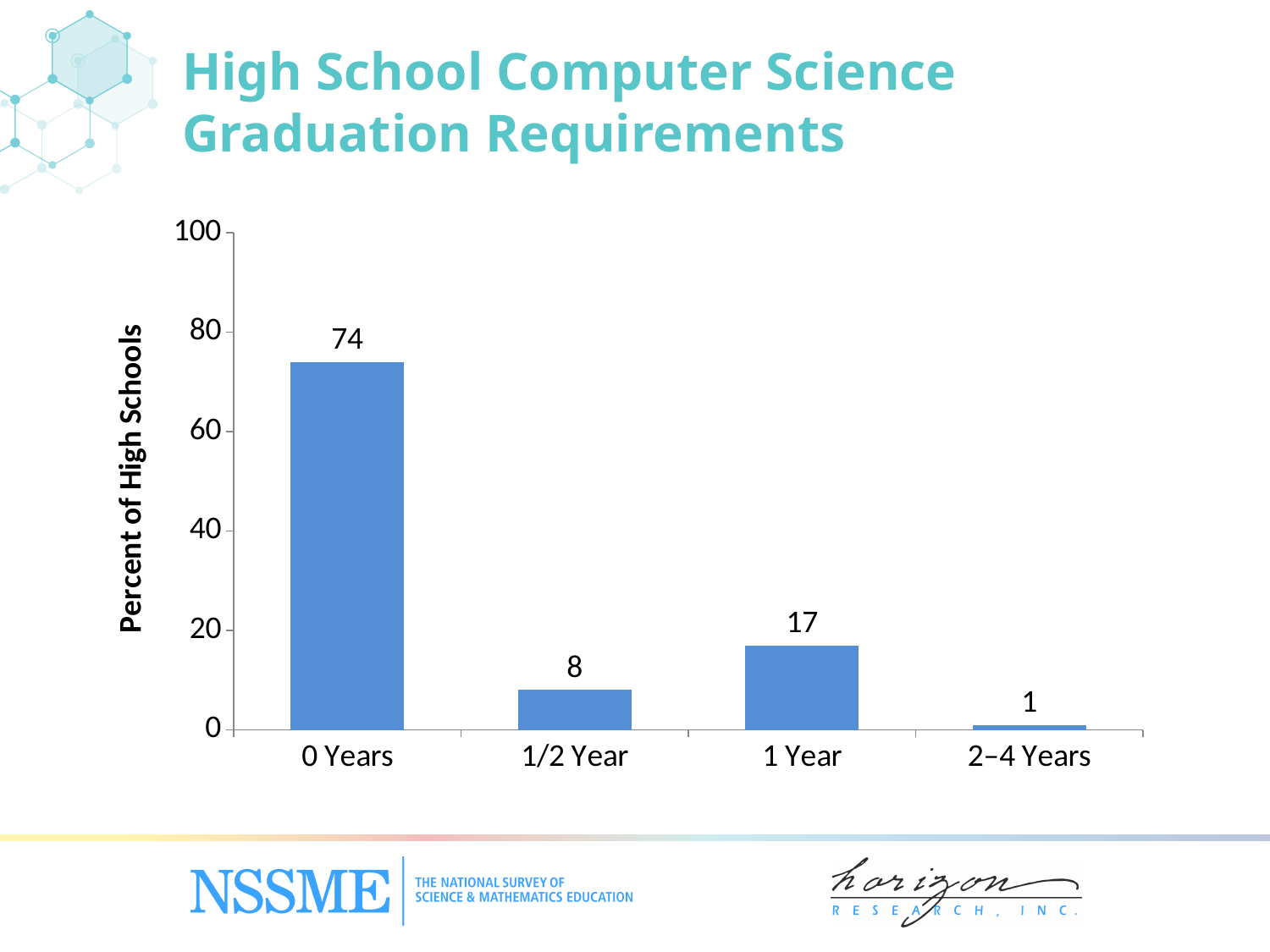
What is the value for 1 Year? 17 What is the difference between the values for 0 Years and 1 Year? 57 What is the value for 1/2 Year? 8 What is the value for 2–4 Years? 1 What is the label of the vertical axis? Percent of High Schools Is the value for 0 Years greater or less than 60? greater Which category has the highest percent of high schools? 0 Years What percent of high schools require 0 years of computer science for graduation? 74 How many categories are shown on the x axis? 4 Which category has the lowest percent of high schools? 2–4 Years Which is larger, the value for 1/2 Year or the value for 1 Year? 1 Year What kind of chart is shown on the slide? bar chart